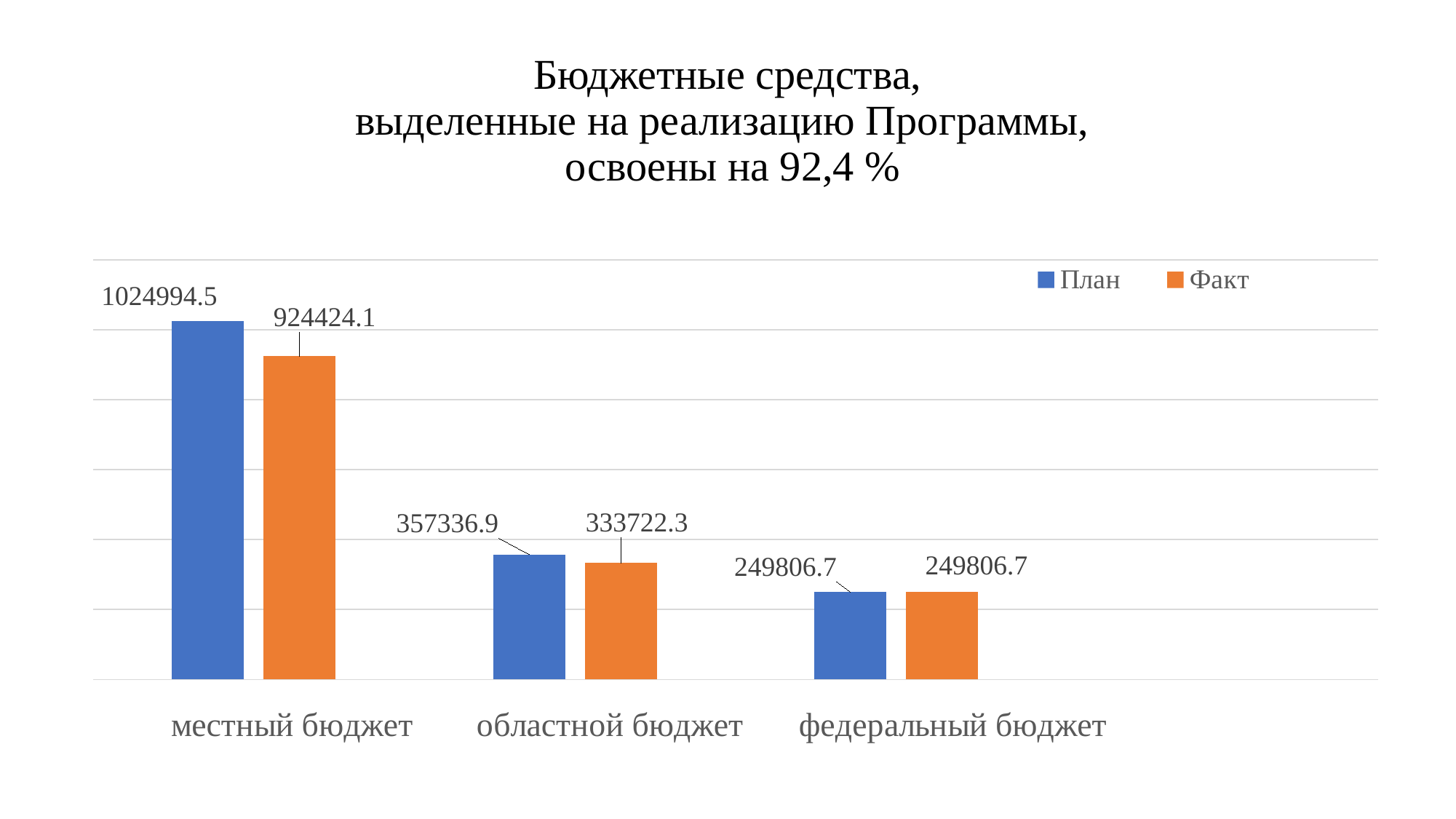
How many categories are shown on the x axis? 3 What is the Факт value for областной бюджет? 333722.3 What is the План value for областной бюджет? 357336.9 What is the difference between the План and Факт values for местный бюджет? 100570.4 What is the Факт value for местный бюджет? 924424.1 Which category has the highest План value? местный бюджет How many series does the legend list? 2 What is the Факт value for федеральный бюджет? 249806.7 Which is larger for областной бюджет, the План value or the Факт value? План What is the План value for местный бюджет? 1024994.5 Which category has the lowest Факт value? федеральный бюджет What is the difference between the План and Факт values for областной бюджет? 23614.6